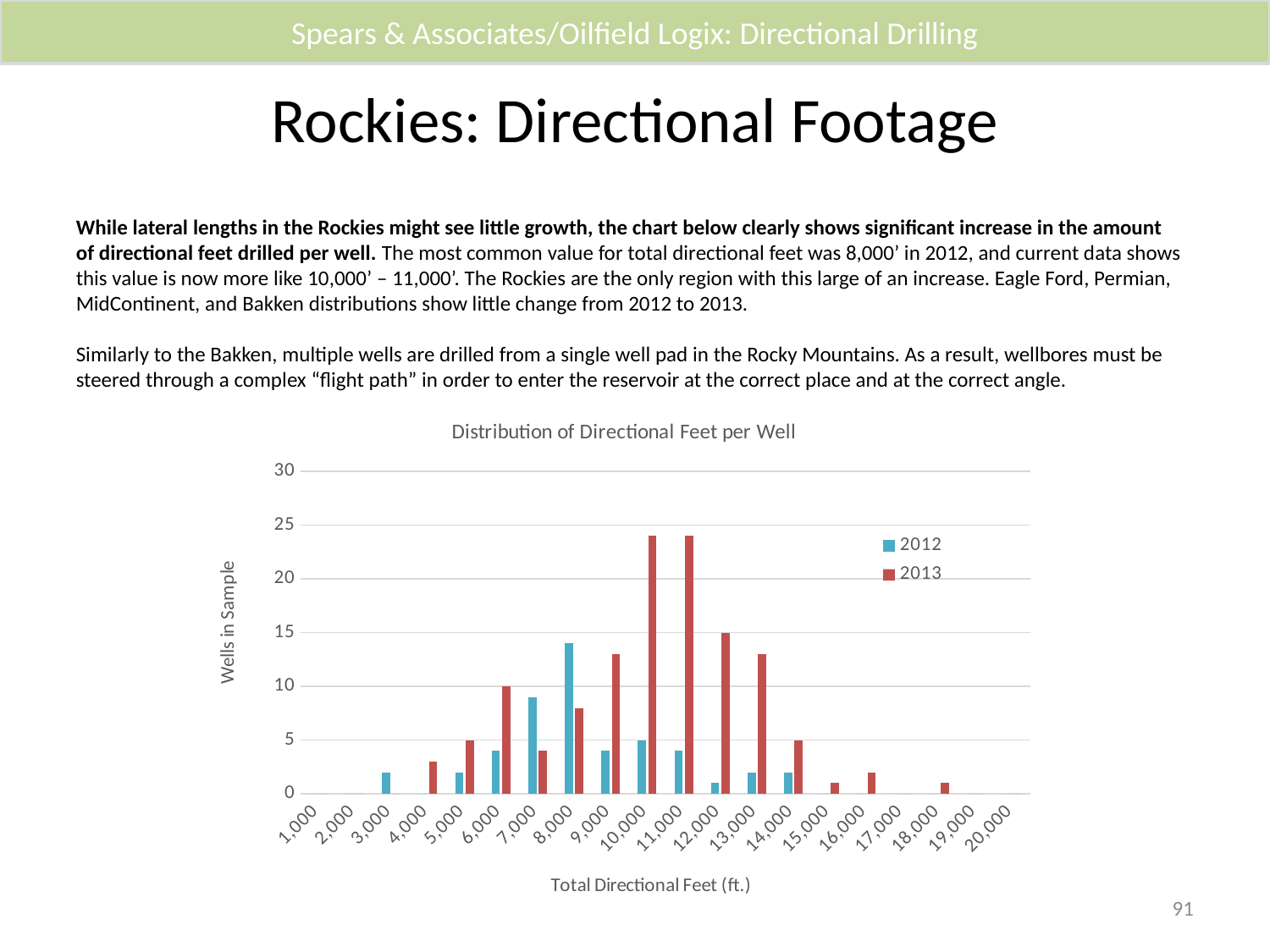
Which category has the highest value for the 2012 series? 8,000 What kind of chart is shown on the slide? Bar chart What is the title of the chart? Distribution of Directional Feet per Well At 8,000 total directional feet, which series has the larger value, 2012 or 2013? 2012 At 9,000 total directional feet, which series has the larger value, 2012 or 2013? 2013 What is the 2013 value for 12,000 total directional feet? 15 How many categories are shown along the x axis of the chart? 20 Is the 2013 value for 10,000 greater or less than 20? greater Is the 2013 value for 7,000 greater or less than 5? less Is the 2012 value for 8,000 greater or less than 10? greater How many series does the chart legend list? 2 What is the label on the vertical axis of the chart? Wells in Sample